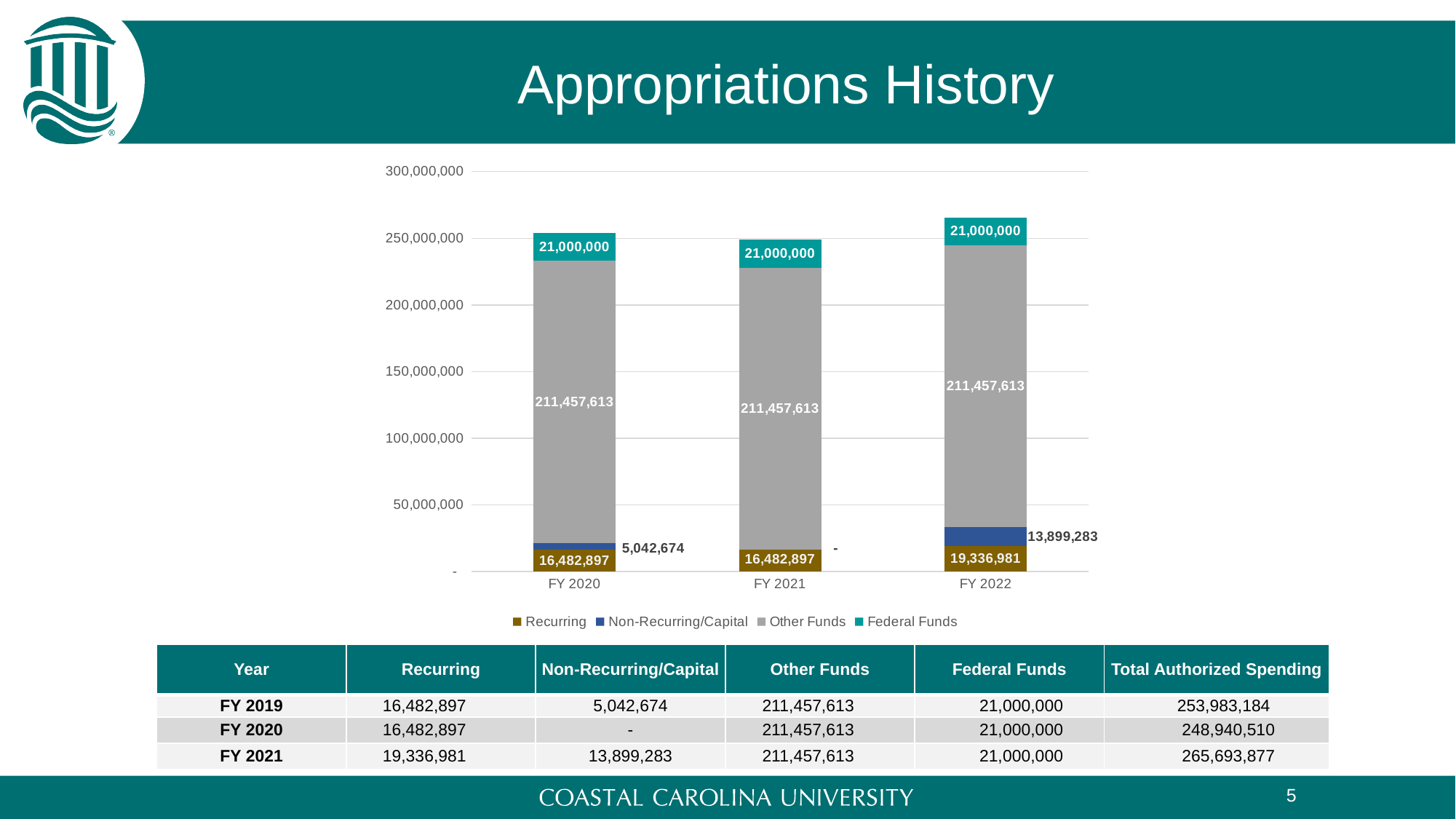
Is the total stacked bar for FY 2022 greater or less than 250,000,000? greater Which fiscal year has the lowest total stacked bar in the chart? FY 2021 What is the Recurring value for FY 2022 in the chart? 19,336,981 How many fiscal years are shown on the x axis of the chart? 3 Is the Non-Recurring/Capital value for FY 2022 larger or smaller than that for FY 2020? larger What is the Federal Funds value for FY 2022 in the chart? 21,000,000 What is the Other Funds value for FY 2021 in the chart? 211,457,613 How many series does the chart legend list? 4 What is the difference between the Recurring values for FY 2022 and FY 2020 in the chart? 2,854,084 Which fiscal year has the highest Non-Recurring/Capital value in the chart? FY 2022 What is the Non-Recurring/Capital value for FY 2020 in the chart? 5,042,674 What is the total of the stacked bar for FY 2020 in the chart? 253,983,184